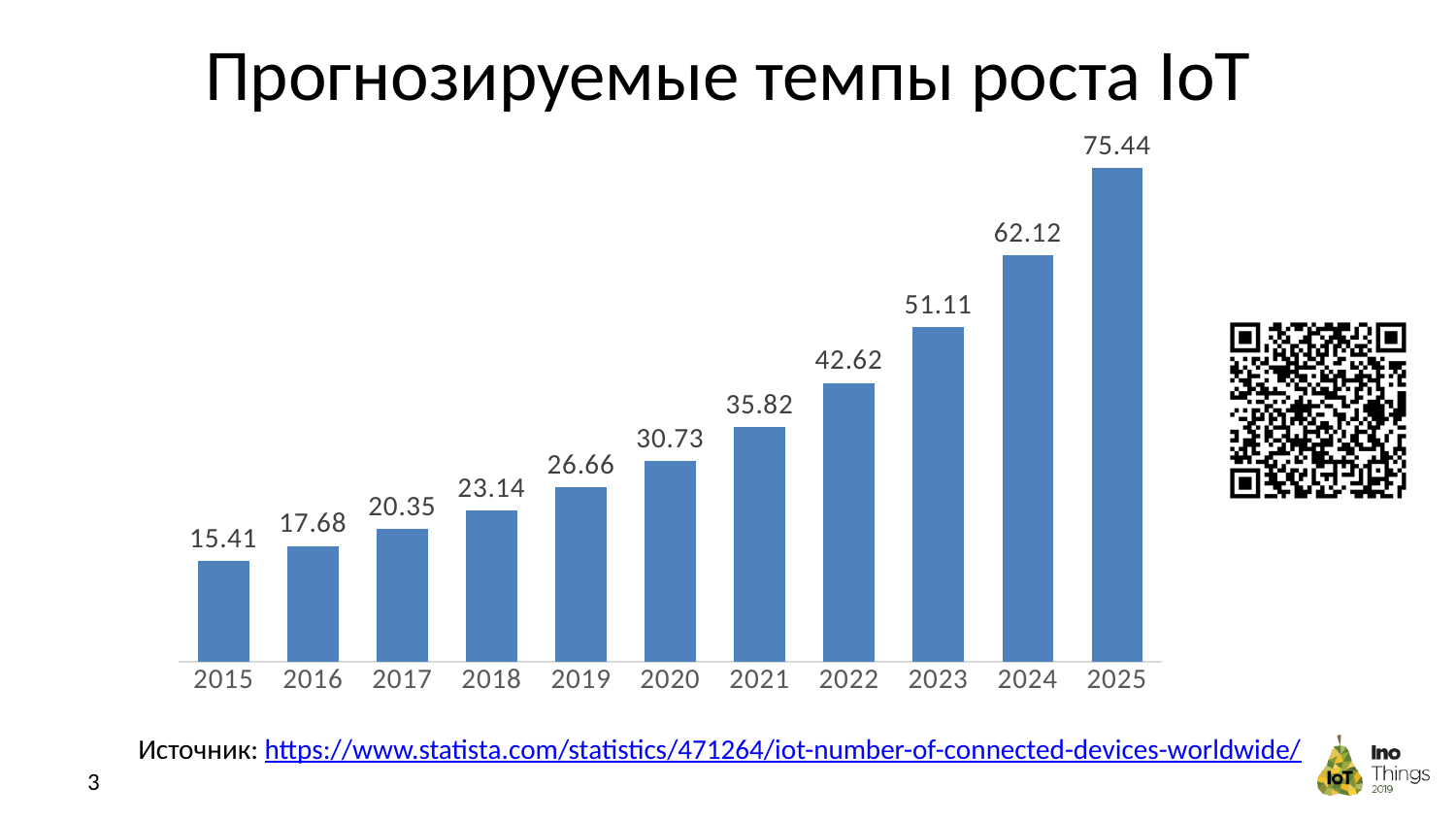
What kind of chart is this? bar chart Which year has the lowest value? 2015 Which year has the highest value? 2025 What is the difference between the values for 2025 and 2024? 13.32 What is the value for 2015? 15.41 What is the value for 2025? 75.44 Which is larger, the value for 2018 or the value for 2021? 2021 What is the difference between the values for 2020 and 2015? 15.32 What is the title of the chart? Прогнозируемые темпы роста IoT What is the value for 2020? 30.73 Do the values rise or fall from 2015 to 2025? rise How many years are shown on the x axis? 11